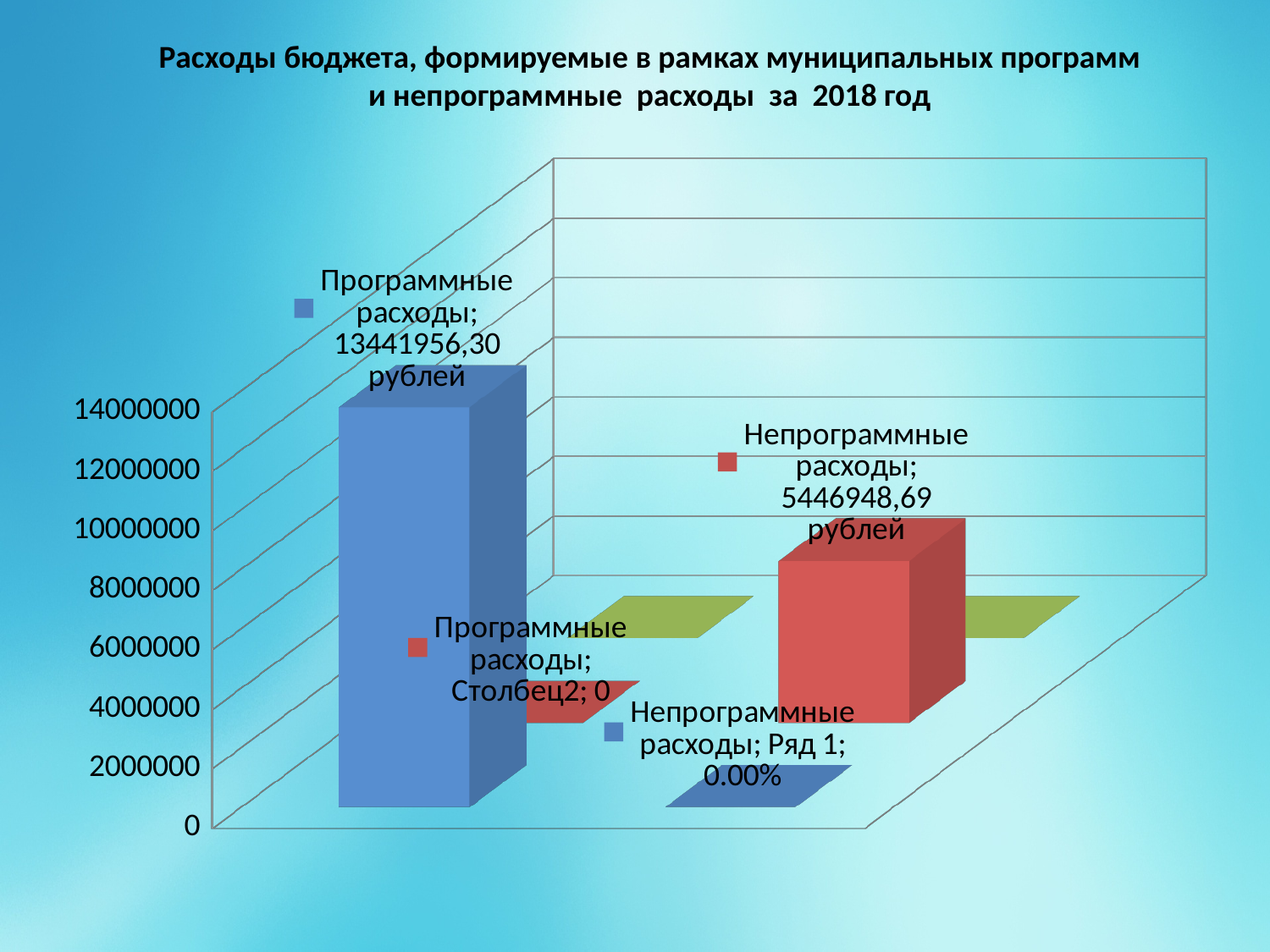
What year does the chart title say the expenses are for? 2018 What is the value shown for Непрограммные расходы? 5446948,69 рублей Is the value for Непрограммные расходы greater or less than 6000000? less How many expense categories are shown in the chart? 2 What kind of chart is shown on the slide? bar chart What is the value shown for Программные расходы? 13441956,30 рублей Which category has the highest value? Программные расходы Which category has the lowest non-zero value? Непрограммные расходы What is the combined total of Программные расходы and Непрограммные расходы? 18888904,99 рублей What is the difference between Программные расходы and Непрограммные расходы? 7995007,61 рублей Is the value for Программные расходы greater or less than 12000000? greater Which is larger, Программные расходы or Непрограммные расходы? Программные расходы